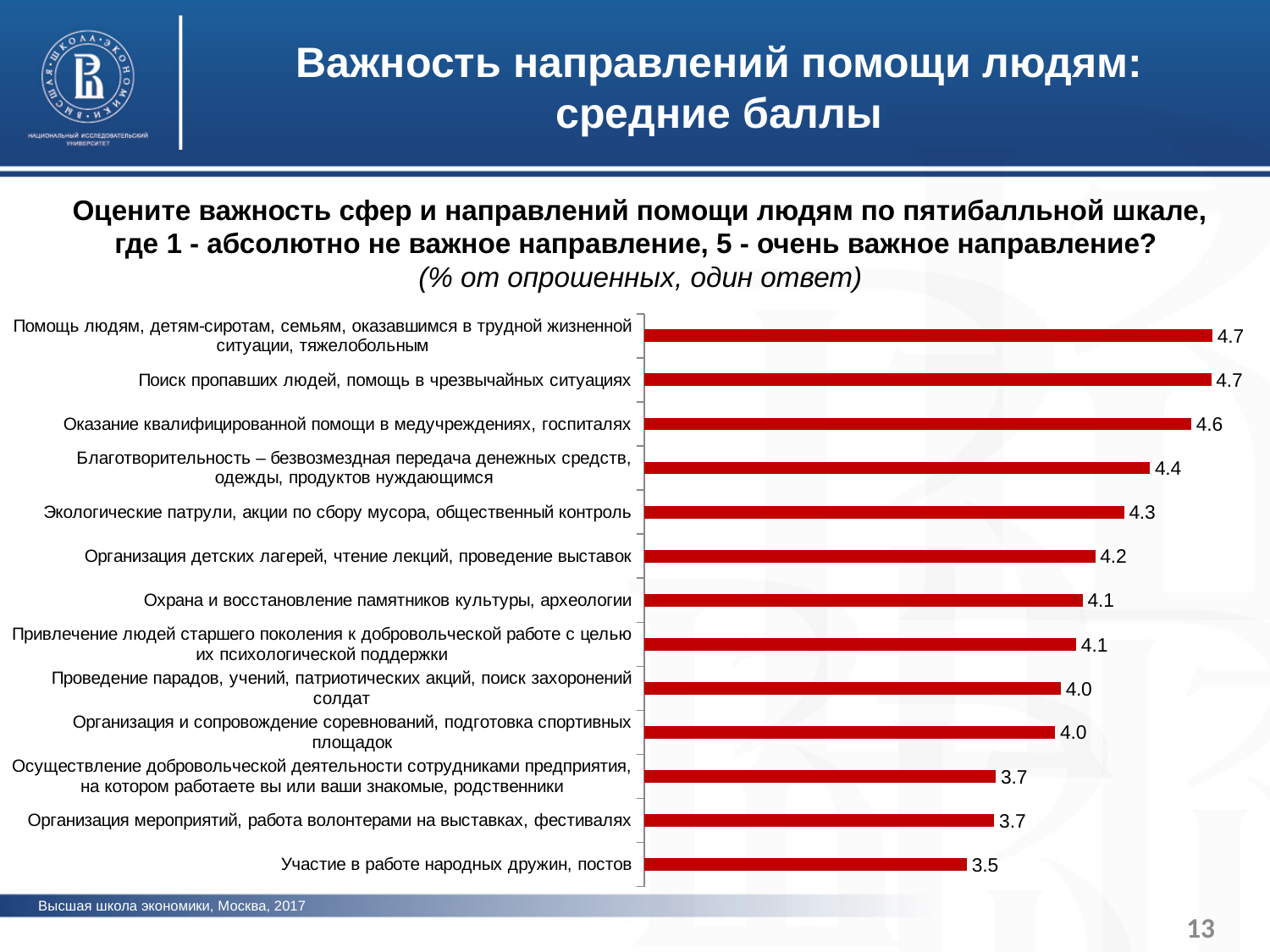
What is the average score for «Организация мероприятий, работа волонтерами на выставках, фестивалях»? 3.7 What is the average score for «Участие в работе народных дружин, постов»? 3.5 How many categories (directions of help) are plotted in the chart? 13 What is the difference between the score for «Помощь людям, детям-сиротам, семьям, оказавшимся в трудной жизненной ситуации, тяжелобольным» and the score for «Участие в работе народных дружин, постов»? 1.2 What is the average score for «Оказание квалифицированной помощи в медучреждениях, госпиталях»? 4.6 Do the bar values increase or decrease going from the top of the chart to the bottom? Decrease Which has a higher average score: «Благотворительность – безвозмездная передача денежных средств, одежды, продуктов нуждающимся» or «Организация детских лагерей, чтение лекций, проведение выставок»? Благотворительность – безвозмездная передача денежных средств, одежды, продуктов нуждающимся What is the average score for «Поиск пропавших людей, помощь в чрезвычайных ситуациях»? 4.7 Which direction of help has the lowest average score? Участие в работе народных дружин, постов What is the average score for «Экологические патрули, акции по сбору мусора, общественный контроль»? 4.3 What colour are the bars in the chart? Red What type of chart is shown on the slide? Bar chart